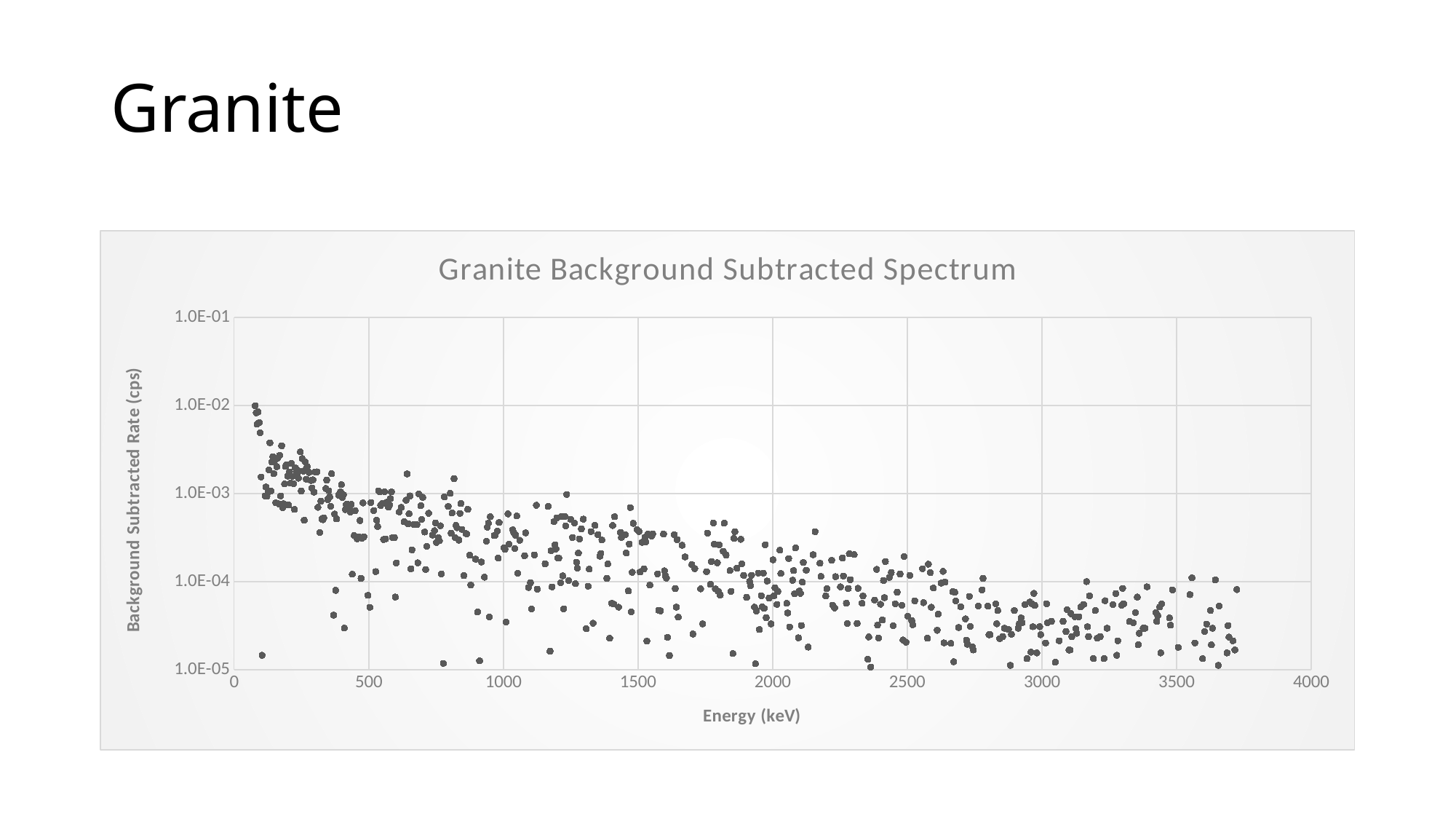
Is the y axis scale linear or logarithmic? Logarithmic Is the highest plotted rate greater or less than 1.0E-01 cps? less What kind of chart is shown on the slide? Scatter plot Are the points plotted near 3500 keV greater or less than 1.0E-03 cps? less What is the label of the x axis? Energy (keV) What is the title of the chart? Granite Background Subtracted Spectrum Do the plotted rates generally rise or fall as energy increases along the x axis? Fall Are the points plotted near 100 keV greater or less than 1.0E-04 cps? greater